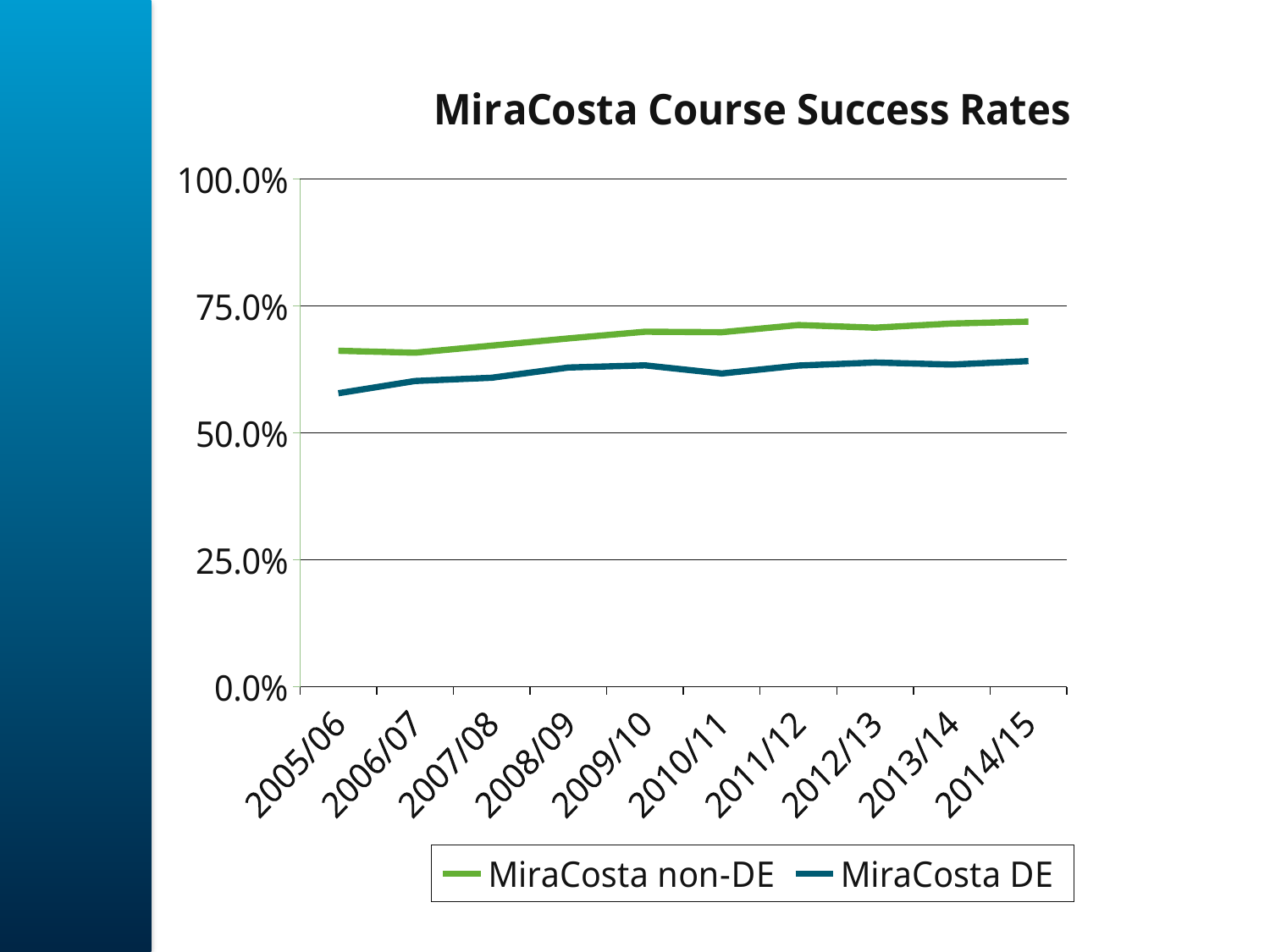
What kind of chart is shown on the slide? line chart Which year has the lowest value for MiraCosta DE? 2005/06 What is the title of the chart? MiraCosta Course Success Rates Is the value for MiraCosta DE in 2010/11 greater or less than 50.0%? greater Is the value for MiraCosta non-DE in 2014/15 greater or less than 50.0%? greater How many academic years are shown on the x axis? 10 Which series has the higher value in 2005/06, MiraCosta non-DE or MiraCosta DE? MiraCosta non-DE Does the MiraCosta non-DE series generally rise or fall from 2005/06 to 2014/15? rise Which series is drawn in green? MiraCosta non-DE Which series has the higher value in 2014/15, MiraCosta non-DE or MiraCosta DE? MiraCosta non-DE How many series does the legend list? 2 Is the value for MiraCosta DE in 2005/06 greater or less than 75.0%? less